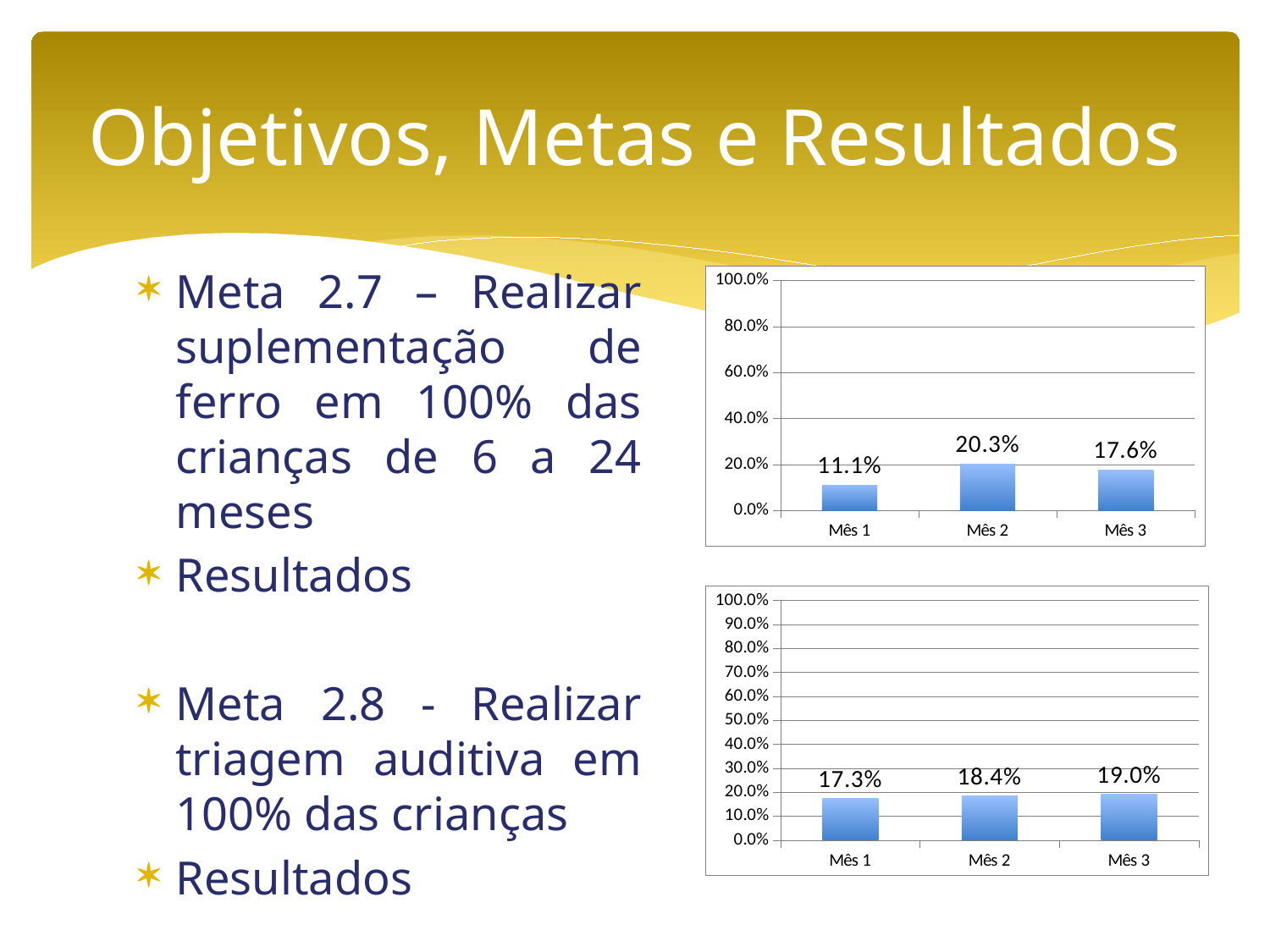
In the top chart, which month has the lowest value? Mês 1 In the top chart, what is the difference between the values for Mês 2 and Mês 1? 9.2 percentage points In the bottom chart, what is the value for Mês 3? 19.0% In the bottom chart, which month has the highest value? Mês 3 In the top chart, is the value for Mês 3 greater or less than 20.0%? less In the top chart, what is the value for Mês 2? 20.3% In the bottom chart, what is the difference between the values for Mês 3 and Mês 1? 1.7 percentage points In the top chart, which month has the highest value? Mês 2 In the bottom chart, what is the value for Mês 1? 17.3% How many categories are shown in the bottom chart? 3 In the bottom chart, do the values rise or fall from Mês 1 to Mês 3? rise In the top chart, what is the value for Mês 1? 11.1%